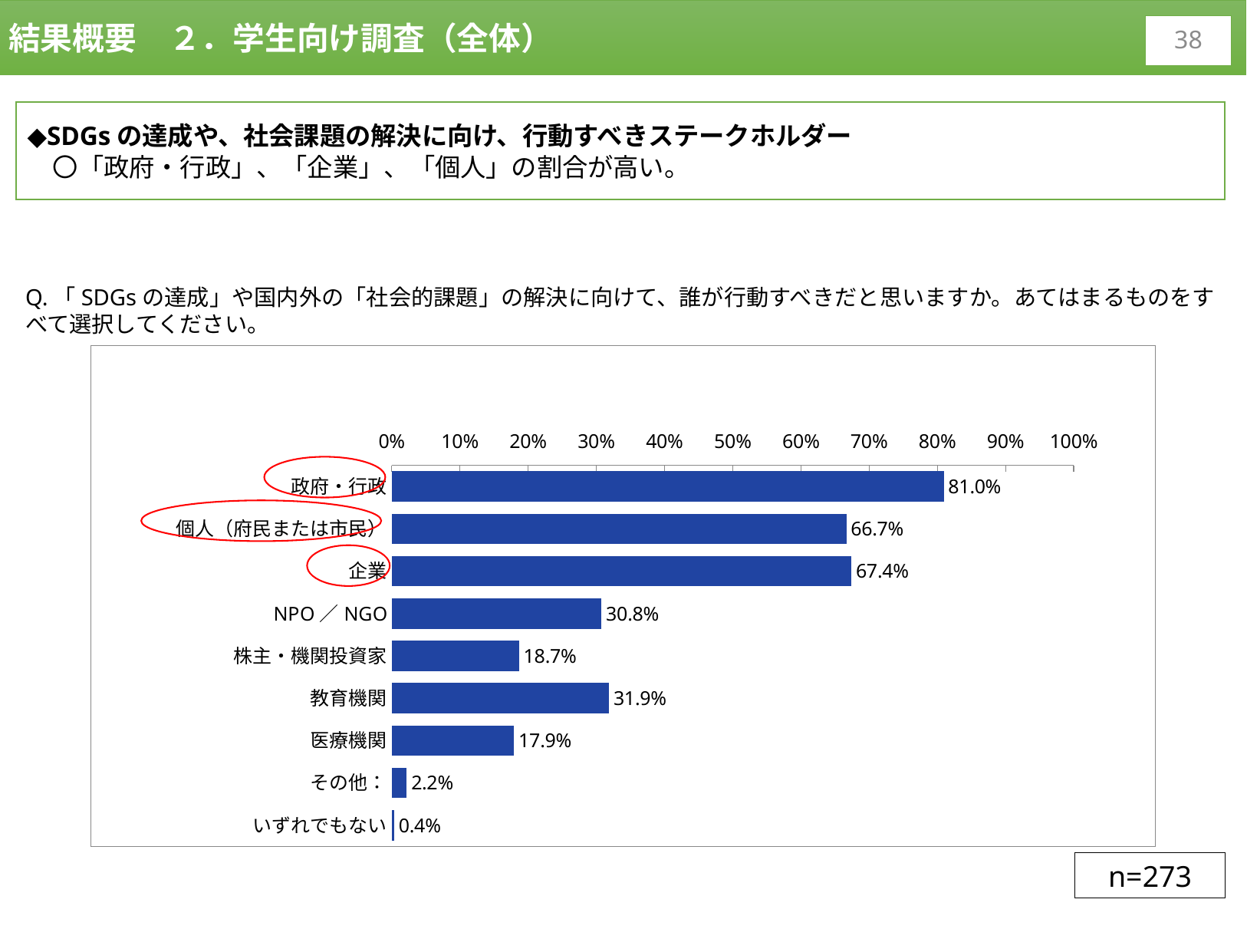
What is the value for 個人（府民または市民）? 66.7% What is the value for 企業? 67.4% What kind of chart is shown on the slide? Bar chart What is the value for 政府・行政? 81.0% How many categories are shown in the chart? 9 Which category has the highest value? 政府・行政 Which is larger, the value for NPO／NGO or the value for 株主・機関投資家? NPO／NGO What is the value for 教育機関? 31.9% Which category has the lowest value? いずれでもない What is the difference between the values for 政府・行政 and 企業? 13.6% What is the value for いずれでもない? 0.4% What is the sample size (n) shown next to the chart? n=273